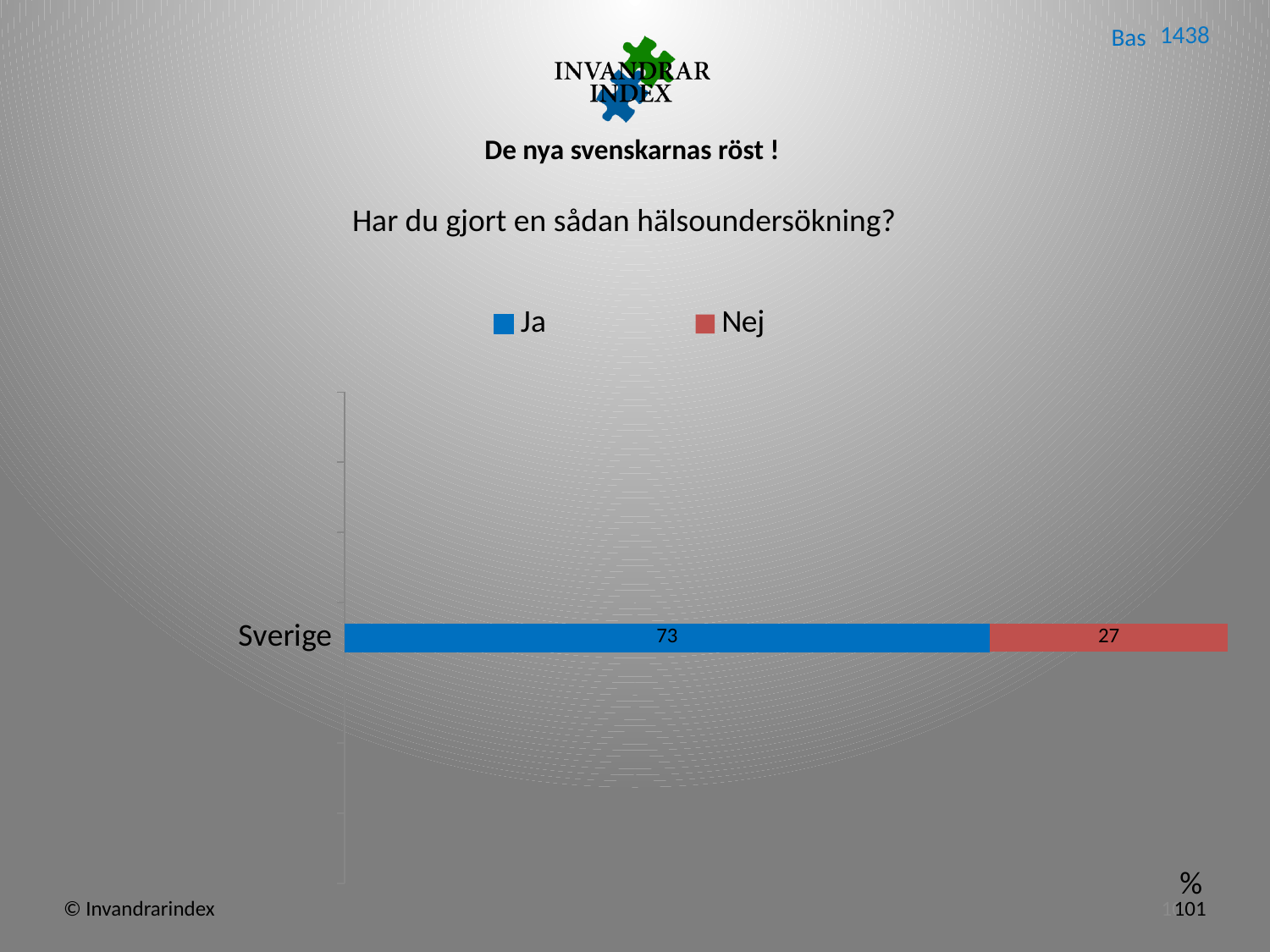
What is the difference between the Ja and Nej values for Sverige? 46 How many series does the legend list? 2 Which series has the larger value for Sverige, Ja or Nej? Ja What is the value for Nej for Sverige? 27 What kind of chart is shown on the slide? Stacked bar chart How many categories are shown on the chart? 1 What is the name of the only category on the chart? Sverige Which series is shown in blue in the legend? Ja What is the total of the stacked bar for Sverige? 100 What is the value for Ja for Sverige? 73